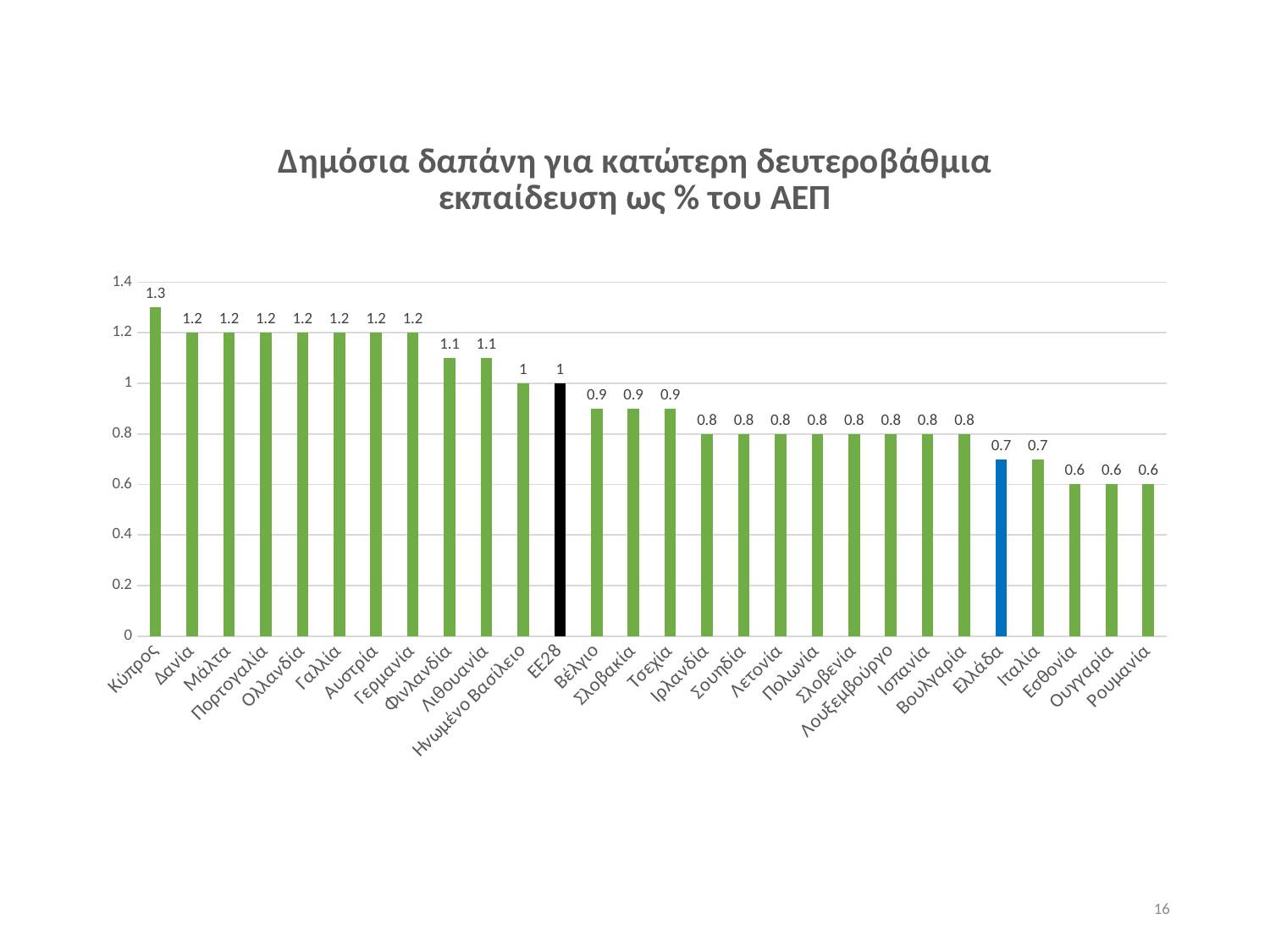
Is the value for Δανία greater or less than 1? greater Which has a larger value, Γερμανία or Ιταλία? Γερμανία What is the value for Ελλάδα? 0.7 Which country has the highest value? Κύπρος What is the value for ΕΕ28? 1 What is the difference between the values for Κύπρος and Ελλάδα? 0.6 Do the values rise or fall from left to right along the x axis? Fall What kind of chart is shown on the slide? Bar chart Which bar is coloured blue? Ελλάδα How many bars are shown in the chart? 28 What is the value for Φινλανδία? 1.1 What is the value for Κύπρος? 1.3